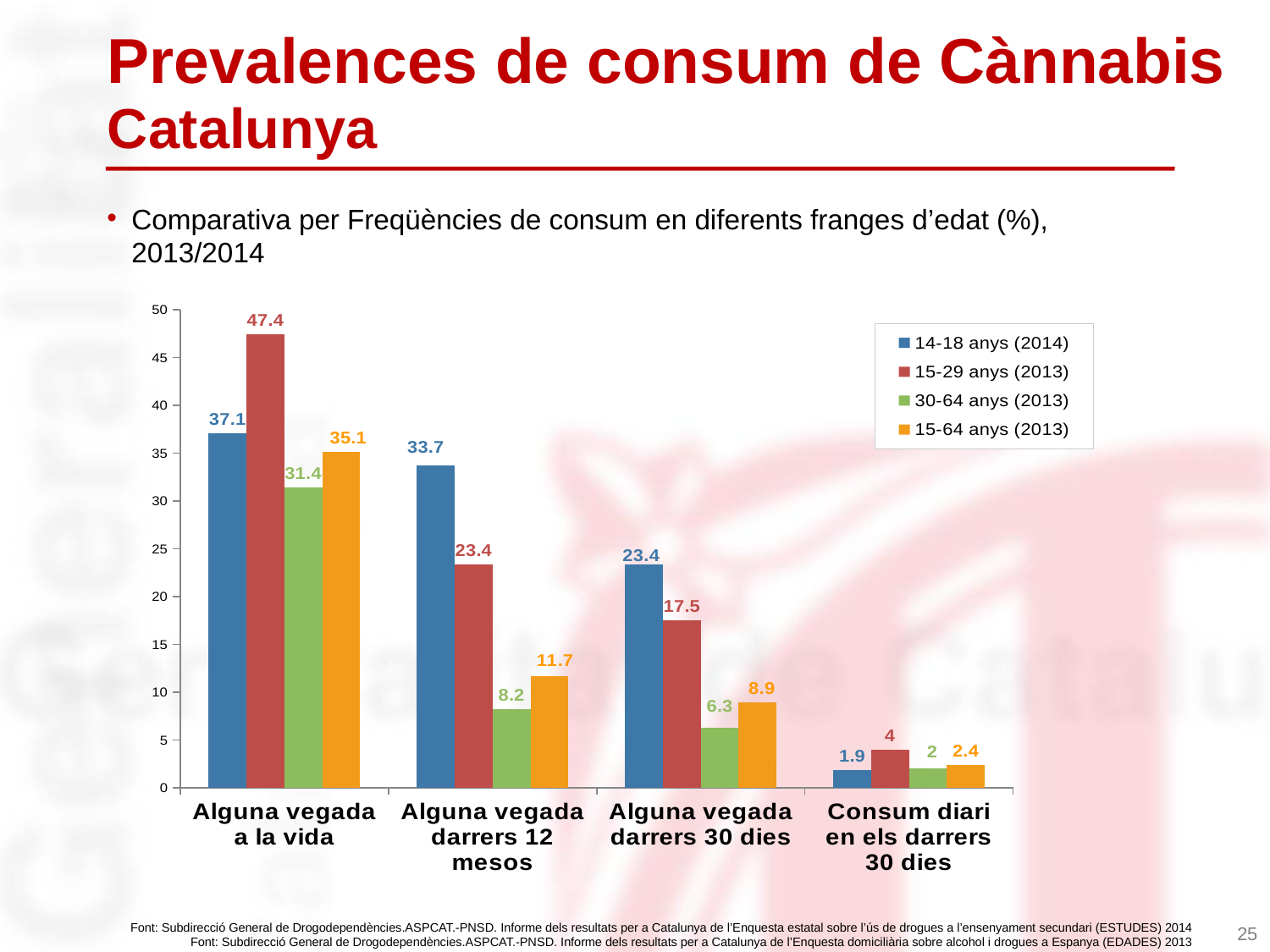
Which is larger in the 'Alguna vegada darrers 30 dies' category: the value for 30-64 anys (2013) or 15-64 anys (2013)? 15-64 anys (2013) What kind of chart is shown on the slide? Bar chart Which age group has the highest value in the 'Alguna vegada a la vida' category? 15-29 anys (2013) Do the values for 14-18 anys (2014) rise or fall across the categories from left to right? Fall What is the value for 15-29 anys (2013) in the 'Alguna vegada a la vida' category? 47.4 What is the difference between the 14-18 anys (2014) and 15-29 anys (2013) values in the 'Alguna vegada darrers 12 mesos' category? 10.3 How many series does the legend list? 4 How many categories are shown on the x axis? 4 What is the value for 30-64 anys (2013) in the 'Alguna vegada darrers 12 mesos' category? 8.2 Which age group has the lowest value in the 'Consum diari en els darrers 30 dies' category? 14-18 anys (2014) What is the value for 14-18 anys (2014) in the 'Alguna vegada darrers 30 dies' category? 23.4 What is the value for 15-64 anys (2013) in the 'Consum diari en els darrers 30 dies' category? 2.4